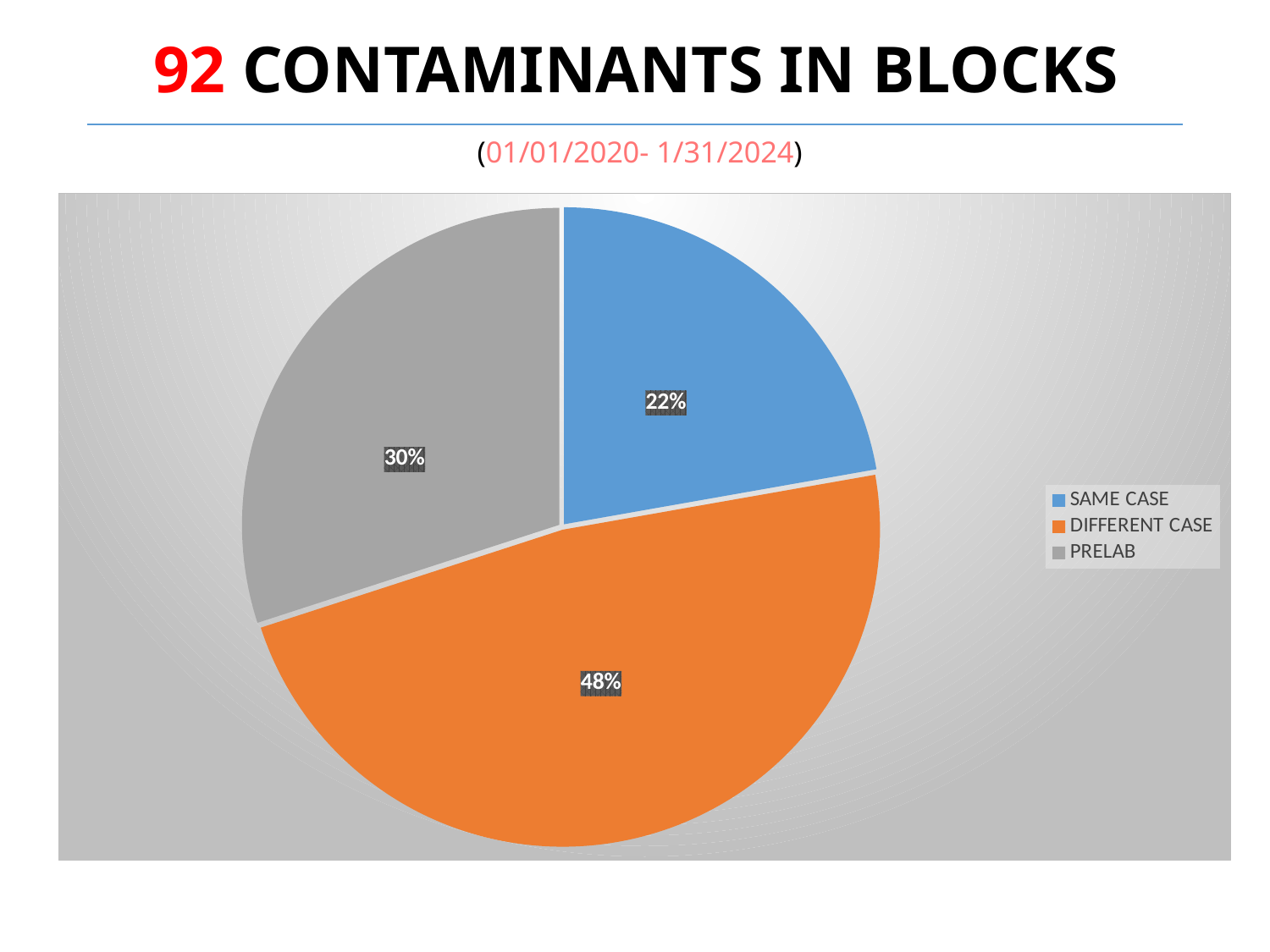
What percentage of contaminants in blocks is labelled SAME CASE? 22% Which category has the largest share of the pie? DIFFERENT CASE What type of chart is shown on the slide? pie chart What colour is the DIFFERENT CASE slice? orange What percentage of contaminants in blocks is labelled PRELAB? 30% How many categories does the pie chart show? 3 How many entries does the legend list? 3 What date range is shown under the slide title? 01/01/2020- 1/31/2024 Which is larger, the PRELAB share or the SAME CASE share? PRELAB Which category has the smallest share of the pie? SAME CASE What percentage of contaminants in blocks is labelled DIFFERENT CASE? 48% What is the difference in percentage points between DIFFERENT CASE and SAME CASE? 26